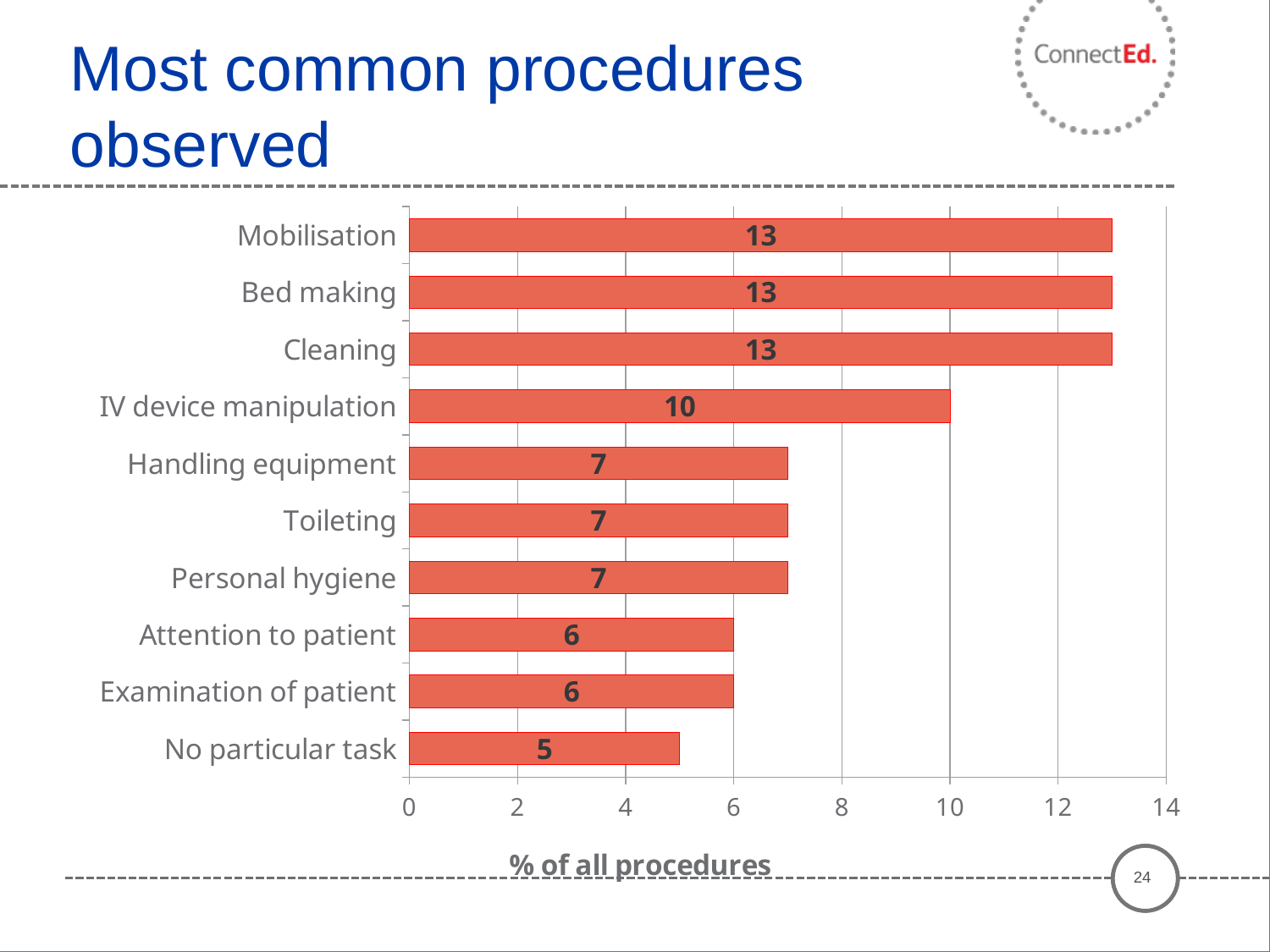
Which category has the lowest value? No particular task Which is larger, the value for Cleaning or the value for Attention to patient? Cleaning Is the value for IV device manipulation greater or less than 8? greater What is the difference between the values for Mobilisation and IV device manipulation? 3 What kind of chart is shown on the slide? bar chart What is the label of the horizontal axis? % of all procedures What is the value for No particular task? 5 What is the value for Handling equipment? 7 What is the value for Examination of patient? 6 What is the difference between the values for Toileting and No particular task? 2 How many categories are shown in the chart? 10 What is the value for IV device manipulation? 10